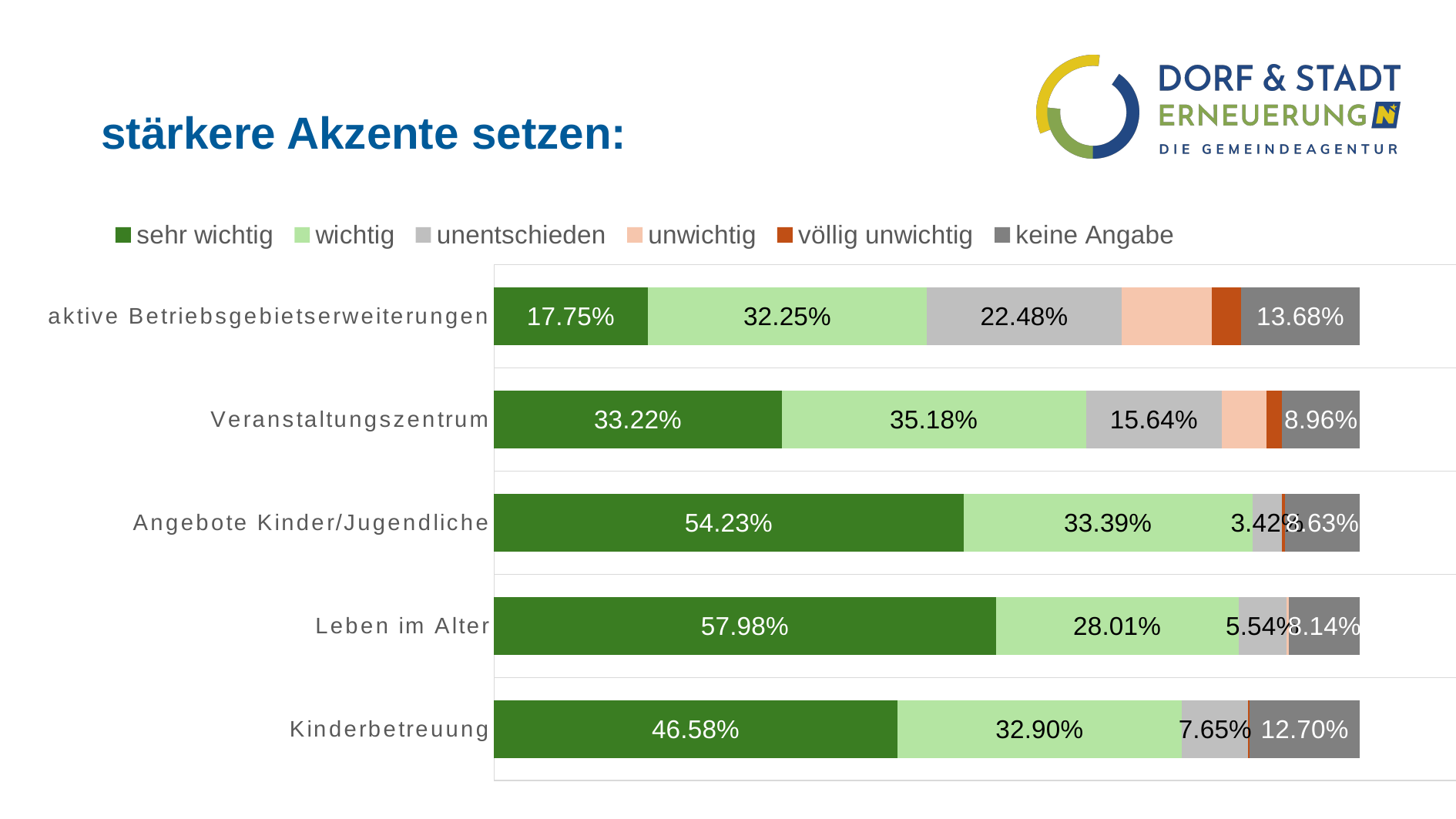
What is the 'unentschieden' value for aktive Betriebsgebietserweiterungen? 22.48% What is the 'sehr wichtig' value for Leben im Alter? 57.98% What kind of chart is shown on the slide? Stacked bar chart What is the 'keine Angabe' value for Kinderbetreuung? 12.70% Which category has the highest 'sehr wichtig' value? Leben im Alter What is the difference between the 'sehr wichtig' values for Angebote Kinder/Jugendliche and Kinderbetreuung? 7.65% What is the 'wichtig' value for Veranstaltungszentrum? 35.18% Which category has the lowest 'sehr wichtig' value? aktive Betriebsgebietserweiterungen How many categories are shown on the chart? 5 How many series does the legend list? 6 Which legend entry is shown in dark green? sehr wichtig Which is larger: the 'wichtig' value for Kinderbetreuung or for Leben im Alter? Kinderbetreuung